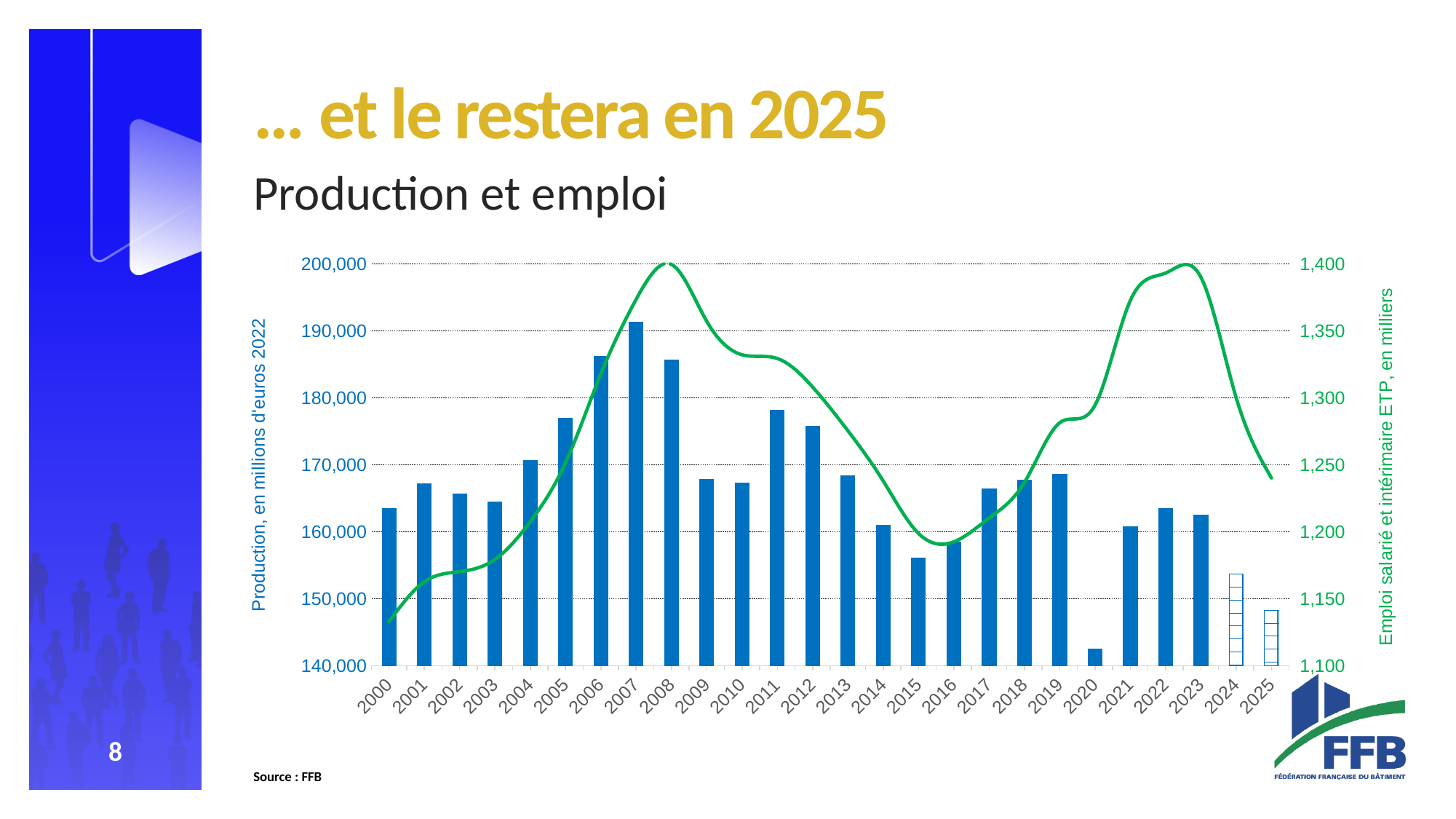
Does the green employment line rise or fall from 2023 to 2025? fall Is the production value for 2020 greater or less than 150,000? less What is the title of the right-hand vertical axis? Emploi salarié et intérimaire ETP, en milliers Is the production value for 2024 greater or less than 150,000? greater Which year has the highest production bar? 2007 Do the production bars rise or fall from 2000 to 2007? rise What kind of chart is shown on the slide? A combined bar and line chart Which year has the lowest production bar? 2020 How many years are shown on the x axis of the chart? 26 Is the employment line value for 2021 greater or less than 1,350? greater Which year has the higher production bar, 2019 or 2020? 2019